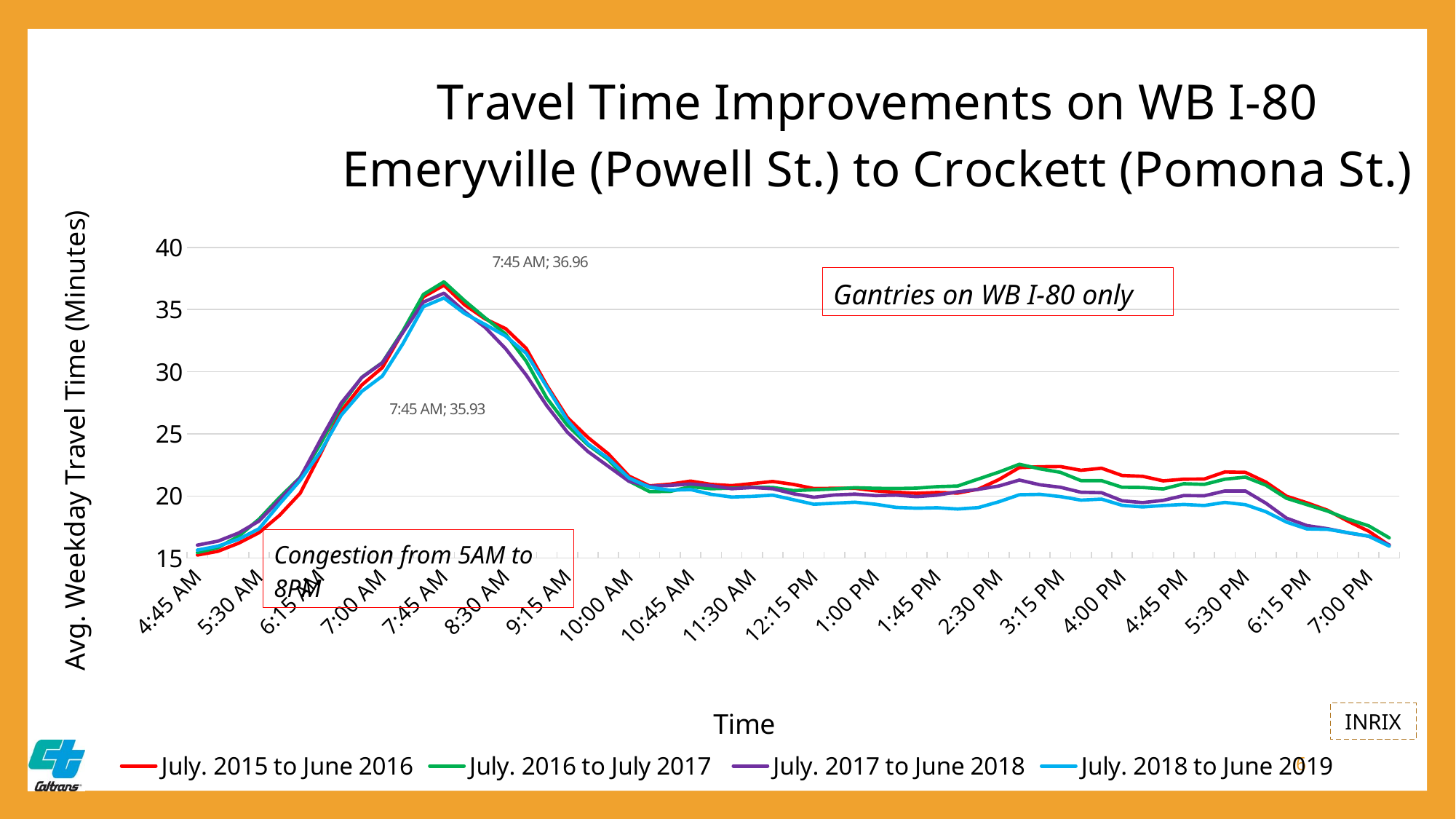
Is the value for July. 2018 to June 2019 at 12:15 PM greater or less than 20? less Which series has the lowest value at the 7:45 AM peak? July. 2018 to June 2019 How many series does the legend list? 4 What is the title of the vertical axis? Avg. Weekday Travel Time (Minutes) At what time do both printed data labels occur? 7:45 AM Which series has the highest value at the 7:45 AM peak? July. 2016 to July 2017 What is the difference between the two labelled values at 7:45 AM (36.96 and 35.93)? 1.03 What is the lower of the two data label values printed on the chart? 35.93 At 4:00 PM, which is larger: the value for July. 2015 to June 2016 or for July. 2018 to June 2019? July. 2015 to June 2016 What is the higher of the two data label values printed on the chart? 36.96 What kind of chart is shown on the slide? line chart Do the travel time values rise or fall between 4:45 AM and 7:45 AM? rise